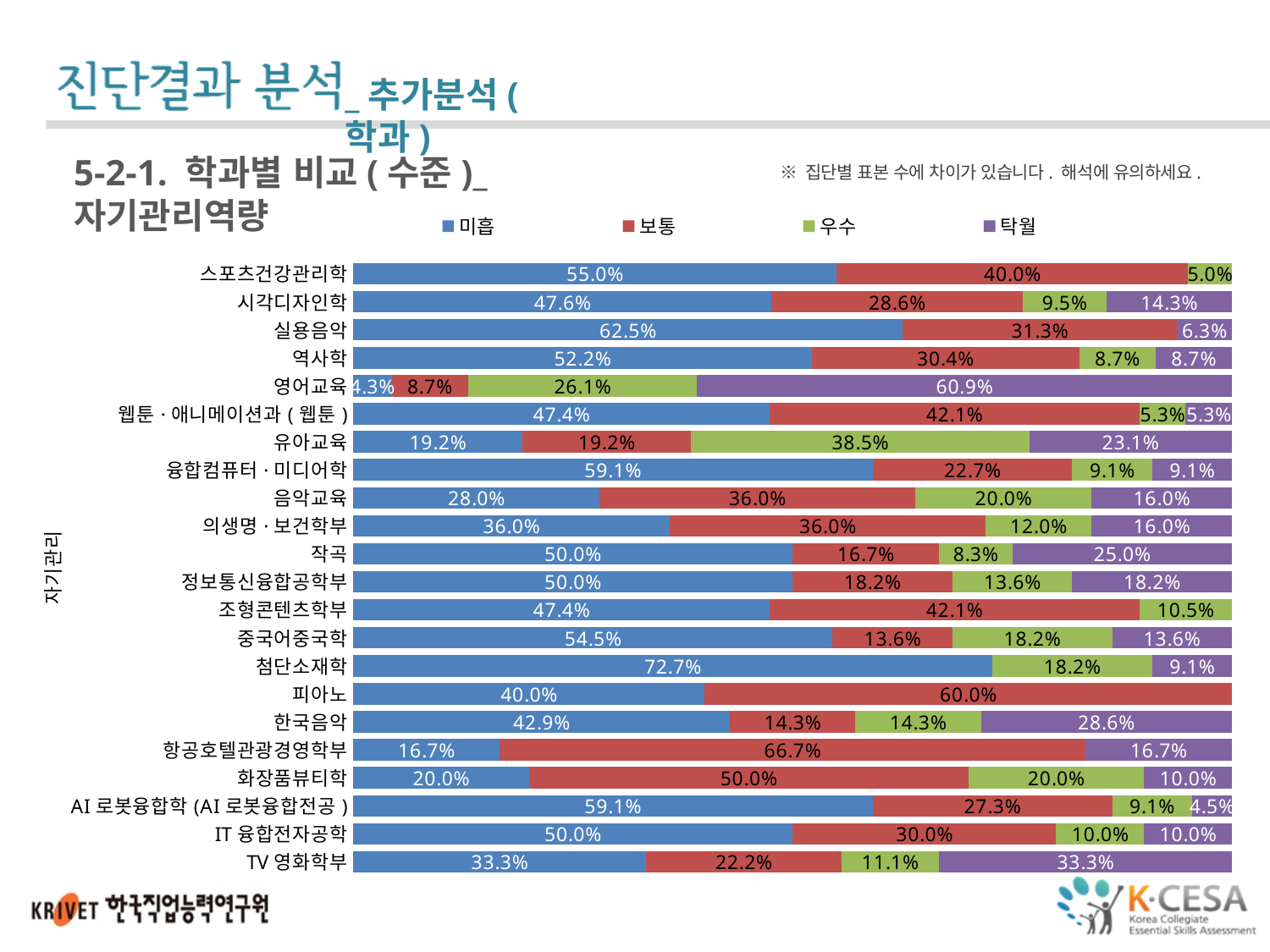
Which is larger for 음악교육: the 미흡 value or the 보통 value? 보통 Which department has the highest 미흡 value? 첨단소재학 What is the 미흡 value for 첨단소재학? 72.7% How many departments are shown in the chart? 22 What is the 탁월 value for 영어교육? 60.9% What kind of chart is shown on the slide? Stacked bar chart Which colour represents the 우수 series in the legend? Green What is the difference between the 미흡 and 보통 values for 피아노? 20.0% What is the 우수 value for 유아교육? 38.5% Which department has the highest 탁월 value? 영어교육 What is the 보통 value for 항공호텔관광경영학부? 66.7% How many series does the legend list? 4